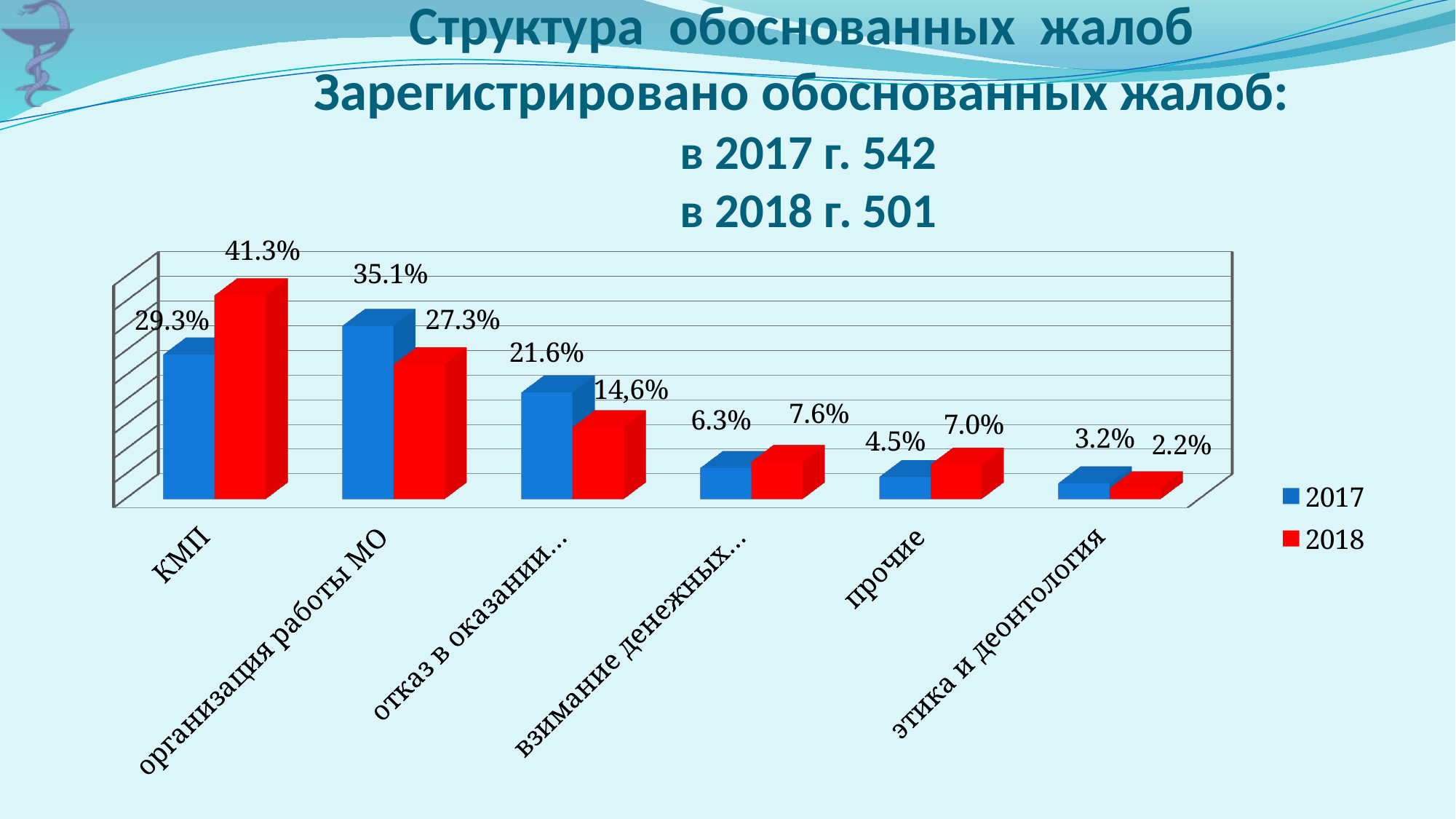
What is the value for этика и деонтология in 2017? 3.2% How many categories are shown on the x axis of the chart? 6 What type of chart is shown on the slide? bar chart Which is larger for организация работы МО: the 2017 value or the 2018 value? 2017 What is the value for КМП in 2018? 41.3% How many series does the legend list? 2 What is the value for организация работы МО in 2017? 35.1% Which category has the lowest value in the 2017 series? этика и деонтология Which category has the highest value in the 2018 series? КМП Which colour represents the 2018 series in the chart? red What is the value for прочие in 2018? 7.0% What is the difference between the 2018 and 2017 values for КМП? 12.0%